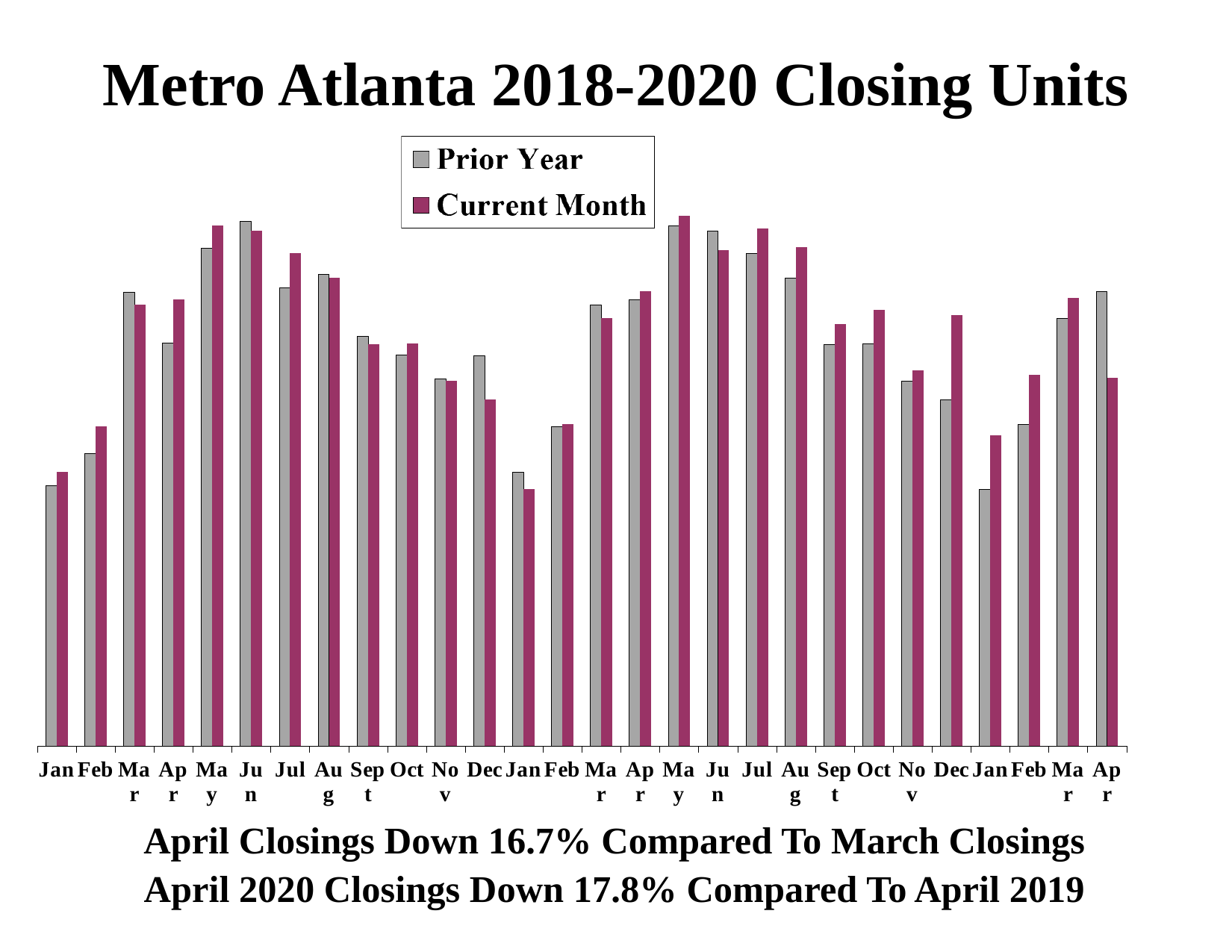
How many series does the legend list? 2 In the second Dec, which is larger: the Prior Year bar or the Current Month bar? Current Month What are the two series named in the legend? Prior Year and Current Month Do the Current Month bars rise or fall from the first Jan to the first Jun? Rise What kind of chart is shown on the slide? Bar chart How many months are shown along the x axis? 28 Do the Current Month bars rise or fall from the first Jun to the first Dec? Fall In the final Apr, which is larger: the Prior Year bar or the Current Month bar? Prior Year What is the title of the chart? Metro Atlanta 2018-2020 Closing Units Which month has the shortest Current Month bar? The second Jan Which month has the tallest Prior Year bar? The first Jun Which month has the tallest Current Month bar? The second May